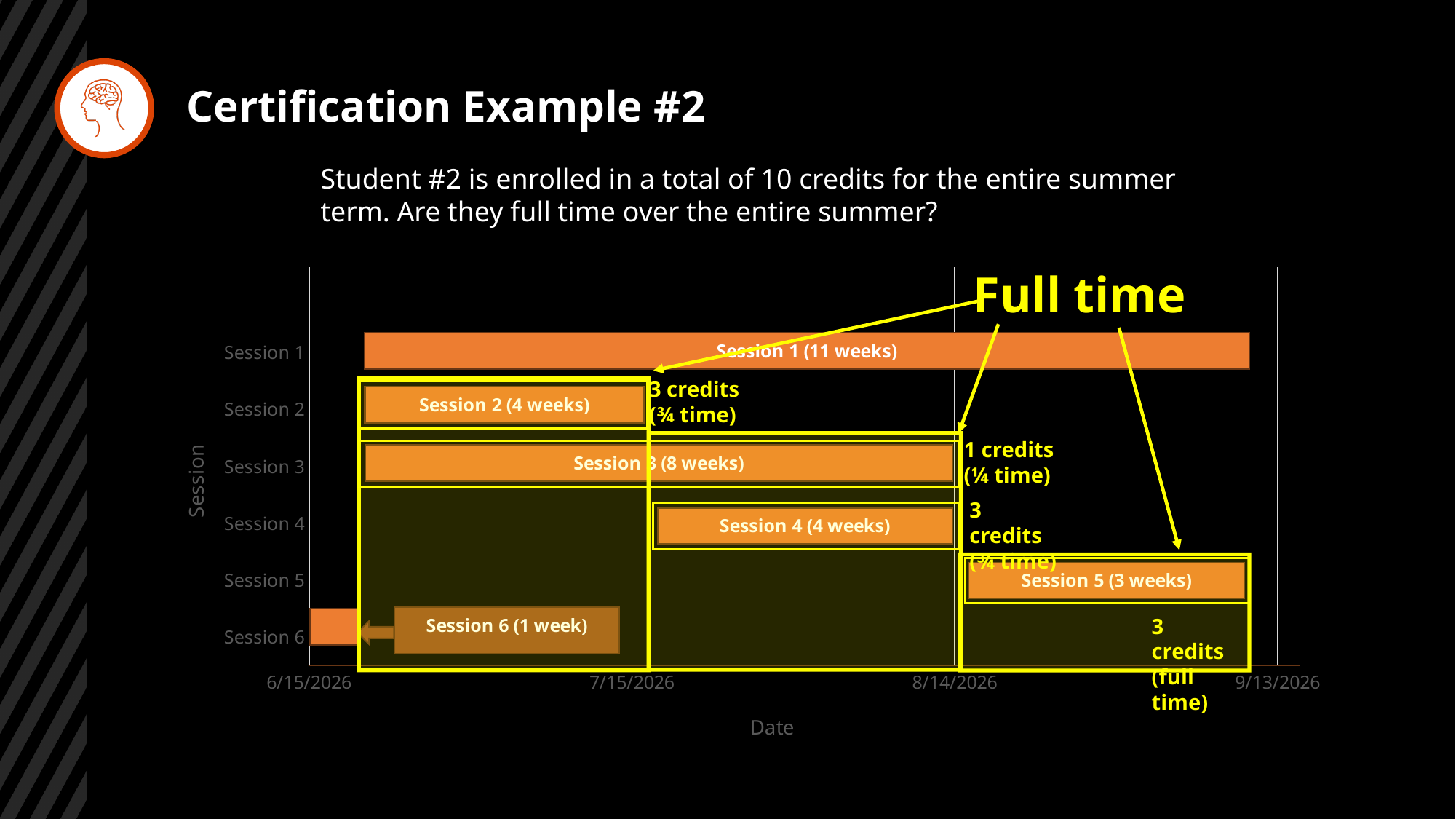
How many weeks long is Session 1 according to its bar label? 11 weeks What is the title of the horizontal axis of the chart? Date Which session is longer, Session 3 or Session 4? Session 3 How many more weeks does Session 1 last than Session 3? 3 weeks What kind of chart is shown on the slide? Bar chart Which session has the longest bar in the chart? Session 1 How many weeks long is Session 5 according to its bar label? 3 weeks How many weeks long is Session 3 according to its bar label? 8 weeks Which session has the shortest bar in the chart? Session 6 How many credits are annotated for Session 3 in the chart? 1 credits (¼ time) What is the first date label shown on the horizontal axis? 6/15/2026 How many sessions are listed on the vertical axis of the chart? 6